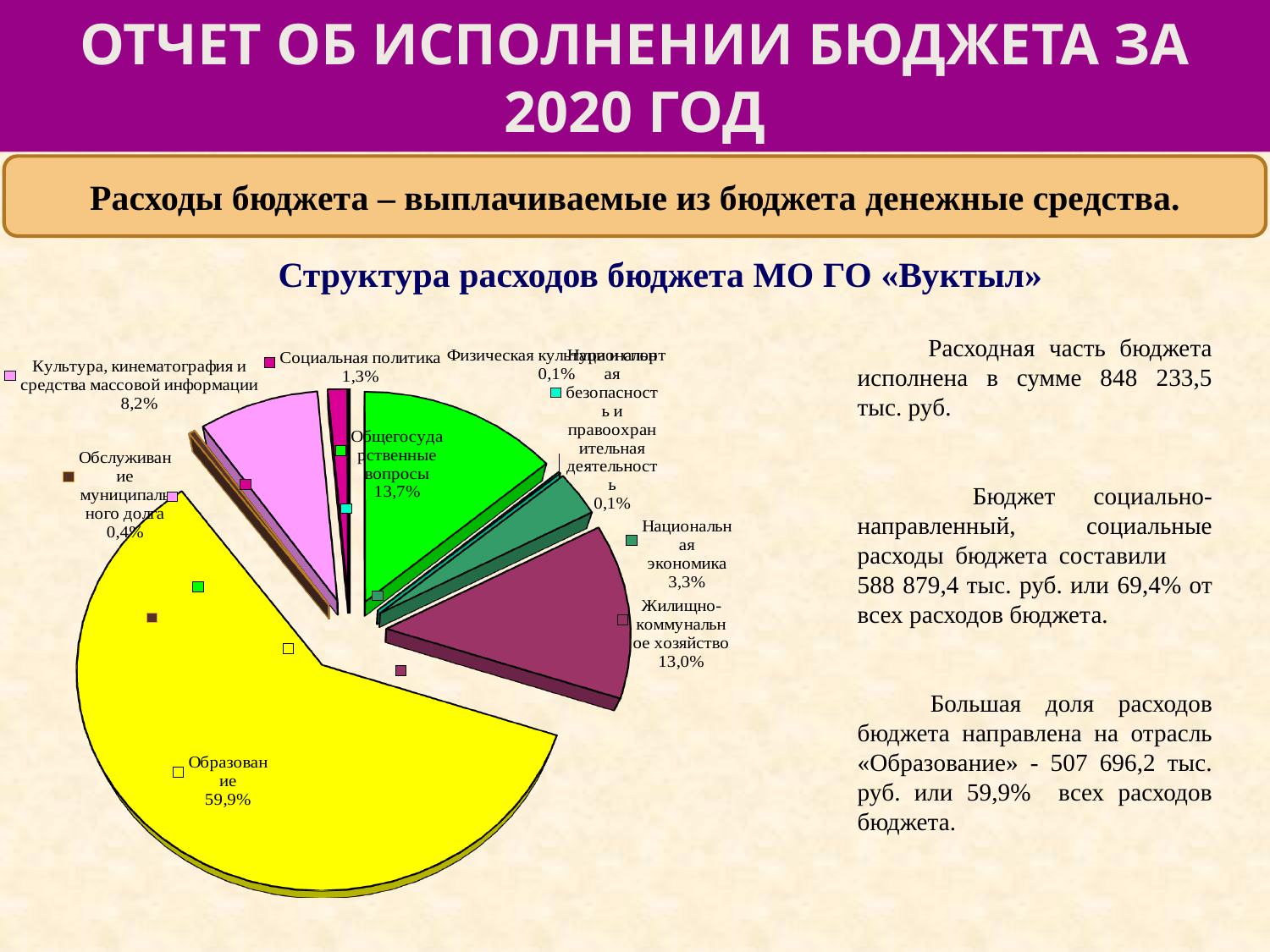
What share does «Социальная политика» have in the pie chart? 1,3% What kind of chart is shown on the slide? pie chart What share does «Жилищно-коммунальное хозяйство» have in the pie chart? 13,0% What share of budget expenditures does «Образование» account for in the pie chart? 59,9% What share does «Национальная экономика» have in the pie chart? 3,3% What share does «Обслуживание муниципального долга» have in the pie chart? 0,4% Which category has the largest slice in the pie chart? Образование Which is larger in the pie chart: «Общегосударственные вопросы» or «Жилищно-коммунальное хозяйство»? Общегосударственные вопросы What share does «Общегосударственные вопросы» have in the pie chart? 13,7% What share does «Культура, кинематография и средства массовой информации» have in the pie chart? 8,2% What is the difference between the shares of «Образование» and «Общегосударственные вопросы» in the pie chart? 46,2% What is the title of the pie chart? Структура расходов бюджета МО ГО «Вуктыл»